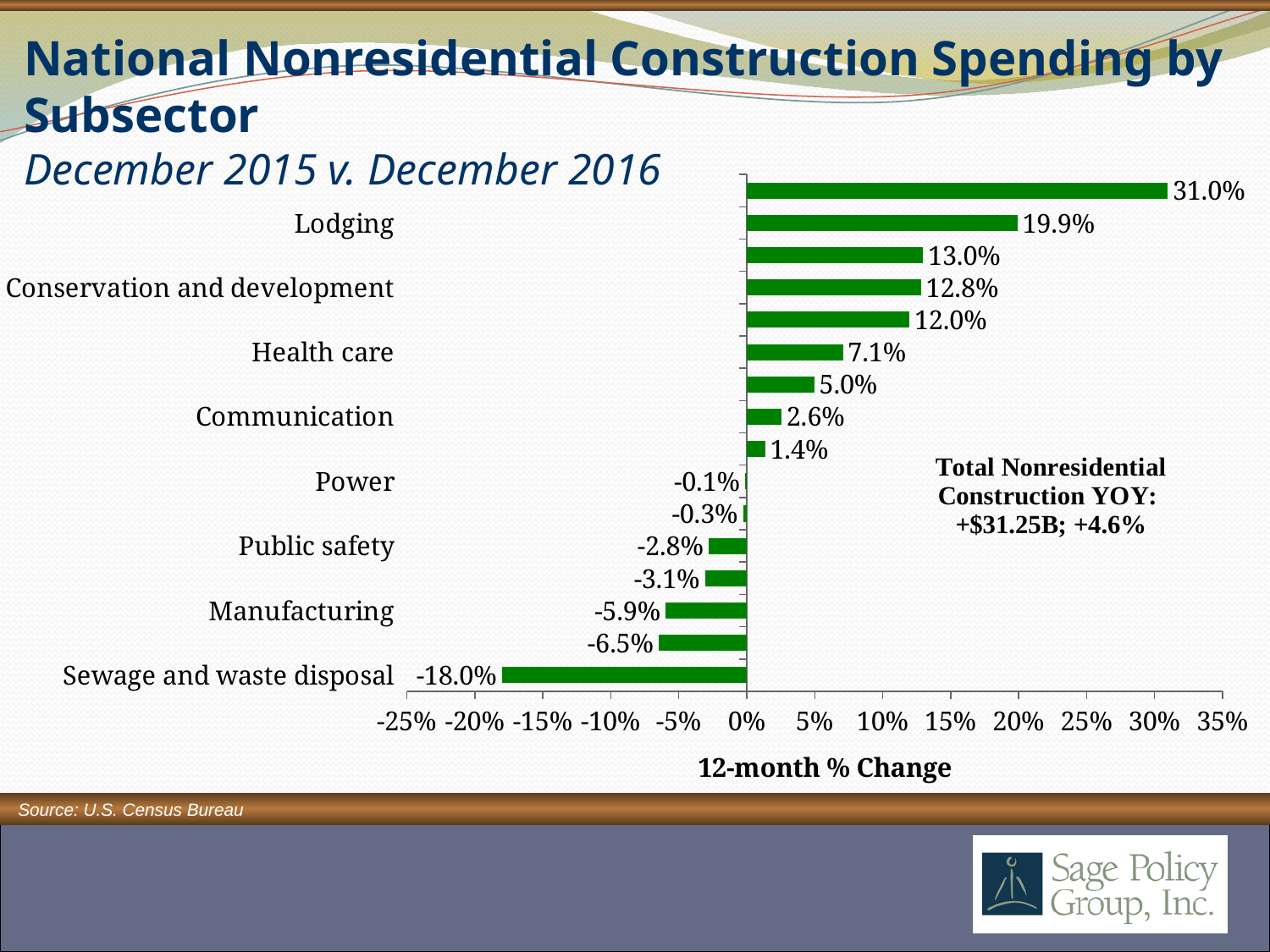
What is the difference between the 12-month % change for Lodging and for Health care? 12.8% What is the 12-month % change for Conservation and development? 12.8% Is the value for Public safety greater or less than 0%? less Which labeled subsector has the lowest 12-month % change? Sewage and waste disposal What is the 12-month % change for Sewage and waste disposal? -18.0% What is the 12-month % change for Lodging? 19.9% What is the title of the horizontal axis? 12-month % Change Which has a larger 12-month % change, Communication or Power? Communication What is the 12-month % change for Health care? 7.1% How many bars are plotted in the chart? 16 What is the 12-month % change for Manufacturing? -5.9% What kind of chart is shown on the slide? Bar chart